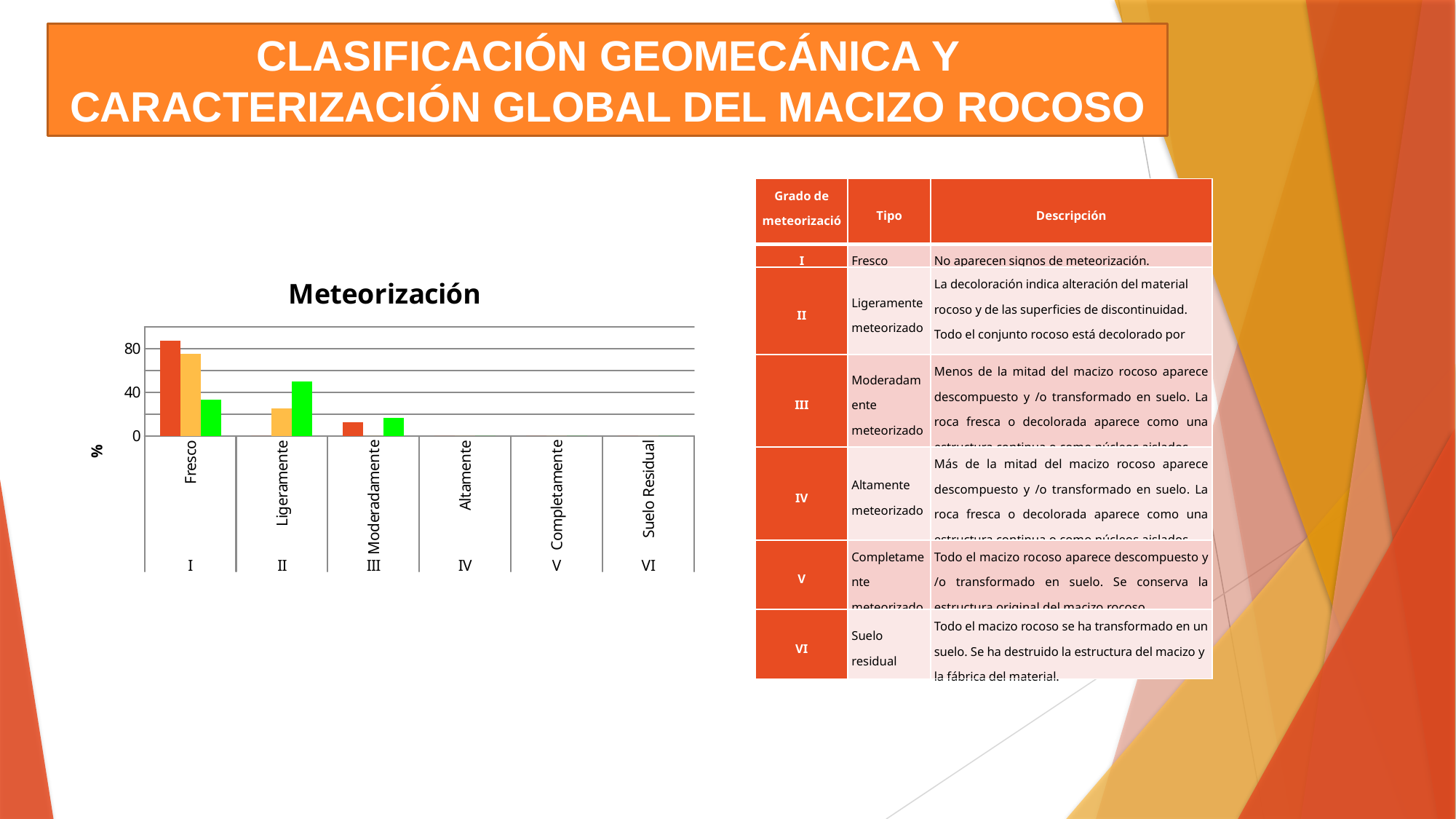
For the Fresco category, which is larger: the red bar or the green bar? the red bar What kind of chart is shown on the slide? bar chart For the Ligeramente category, which is larger: the orange bar or the green bar? the green bar Which category has the tallest bar in the chart? Fresco (I) Is the value of the green bar for Fresco greater or less than 40? less How many weathering grade categories are shown on the x axis of the chart? 6 Is the value of the green bar for Ligeramente greater or less than 40? greater Is the value of the red bar for Fresco greater or less than 80? greater What label is shown on the y axis of the chart? % What is the title of the chart? Meteorización How many bars are plotted for the Fresco category? 3